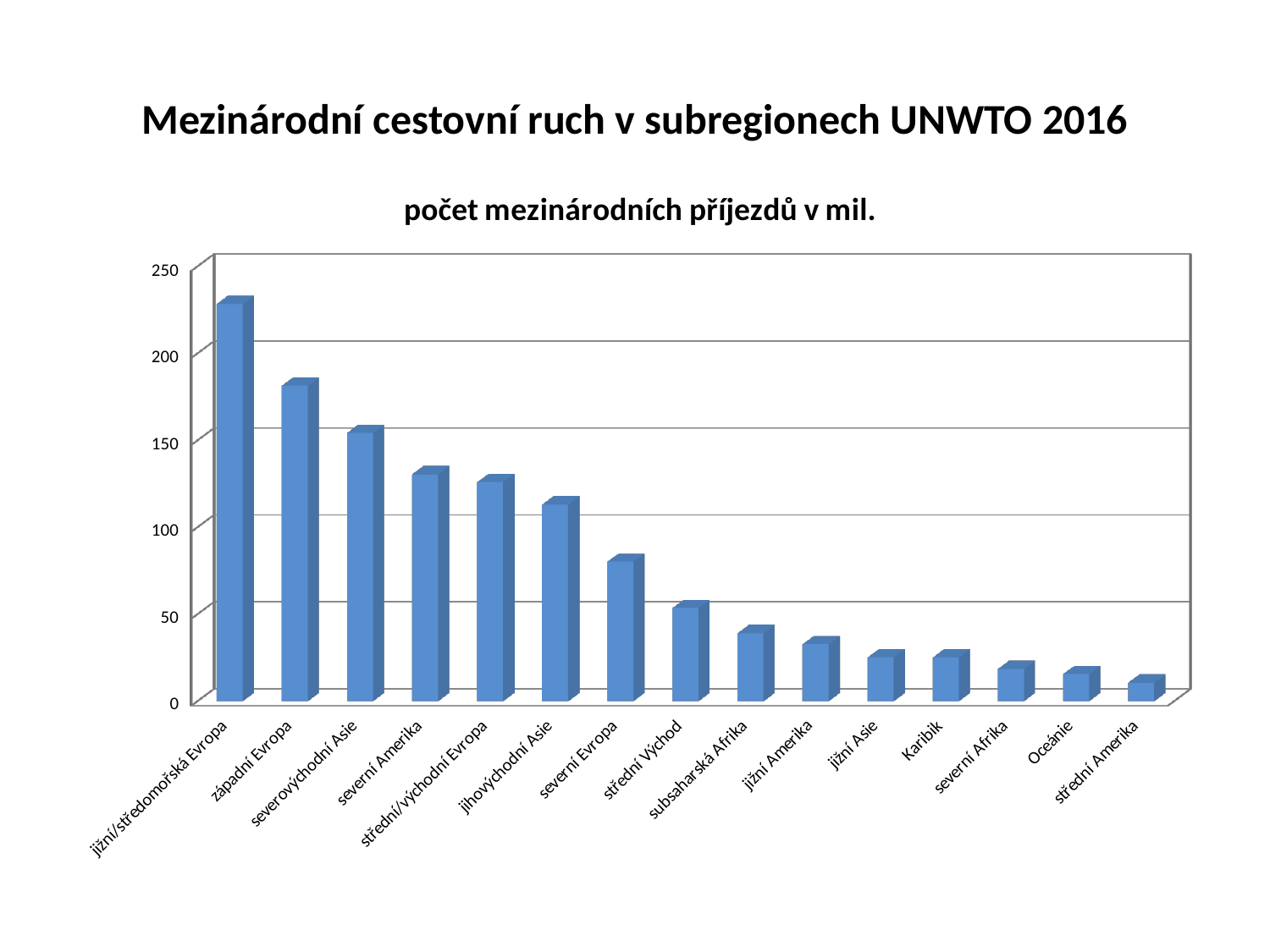
Is the value for subsaharská Afrika greater or less than 50? less What is the title of the chart? počet mezinárodních příjezdů v mil. How many subregions are shown on the x axis? 15 Is the value for západní Evropa greater or less than 200? less Is the value for jižní/středomořská Evropa greater or less than 200? greater What kind of chart is shown on the slide? bar chart Which has more international arrivals, západní Evropa or severní Amerika? západní Evropa Which subregion has the lowest number of international arrivals? střední Amerika Which subregion has the highest number of international arrivals? jižní/středomořská Evropa Do the values rise or fall from left to right along the x axis? fall